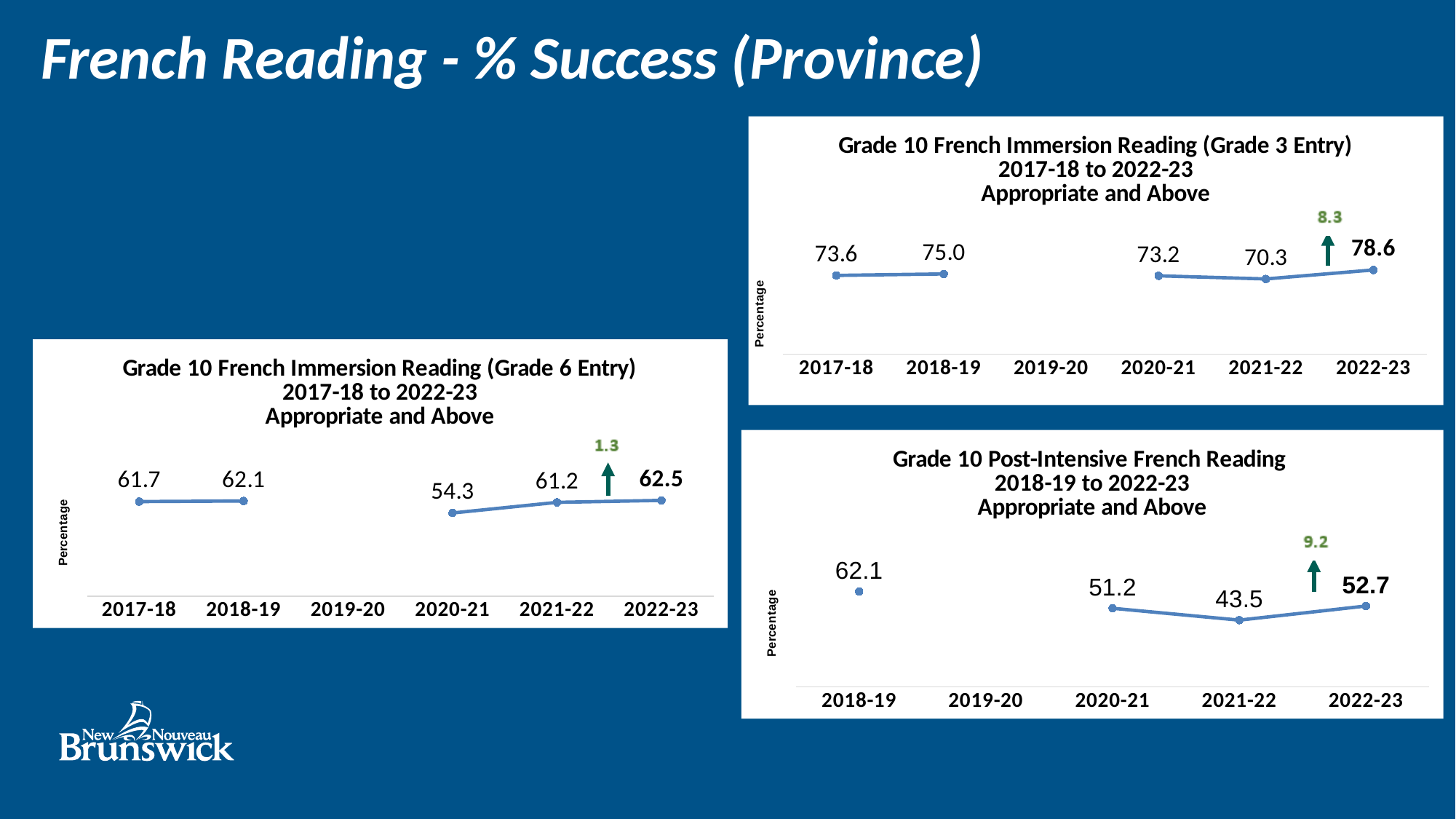
In the Grade 10 French Immersion Reading (Grade 3 Entry) chart, what is the difference between the 2022-23 and 2021-22 values? 8.3 In the Grade 10 French Immersion Reading (Grade 3 Entry) chart, what is the value for 2021-22? 70.3 In the Grade 10 Post-Intensive French Reading chart, how many years have a plotted data point? 4 In the Grade 10 French Immersion Reading (Grade 3 Entry) chart, which is larger, the value for 2017-18 or 2018-19? 2018-19 In the Grade 10 Post-Intensive French Reading chart, which year has the highest value? 2018-19 In the Grade 10 Post-Intensive French Reading chart, what is the difference between the 2022-23 and 2021-22 values? 9.2 In the Grade 10 French Immersion Reading (Grade 6 Entry) chart, which year has the lowest value? 2020-21 In the Grade 10 French Immersion Reading (Grade 3 Entry) chart, which year has the highest value? 2022-23 In the Grade 10 Post-Intensive French Reading chart, what is the value for 2021-22? 43.5 In the Grade 10 French Immersion Reading (Grade 6 Entry) chart, what is the difference between the 2022-23 and 2021-22 values? 1.3 What kind of chart is the Grade 10 French Immersion Reading (Grade 6 Entry) chart? Line chart In the Grade 10 French Immersion Reading (Grade 6 Entry) chart, what is the value for 2020-21? 54.3